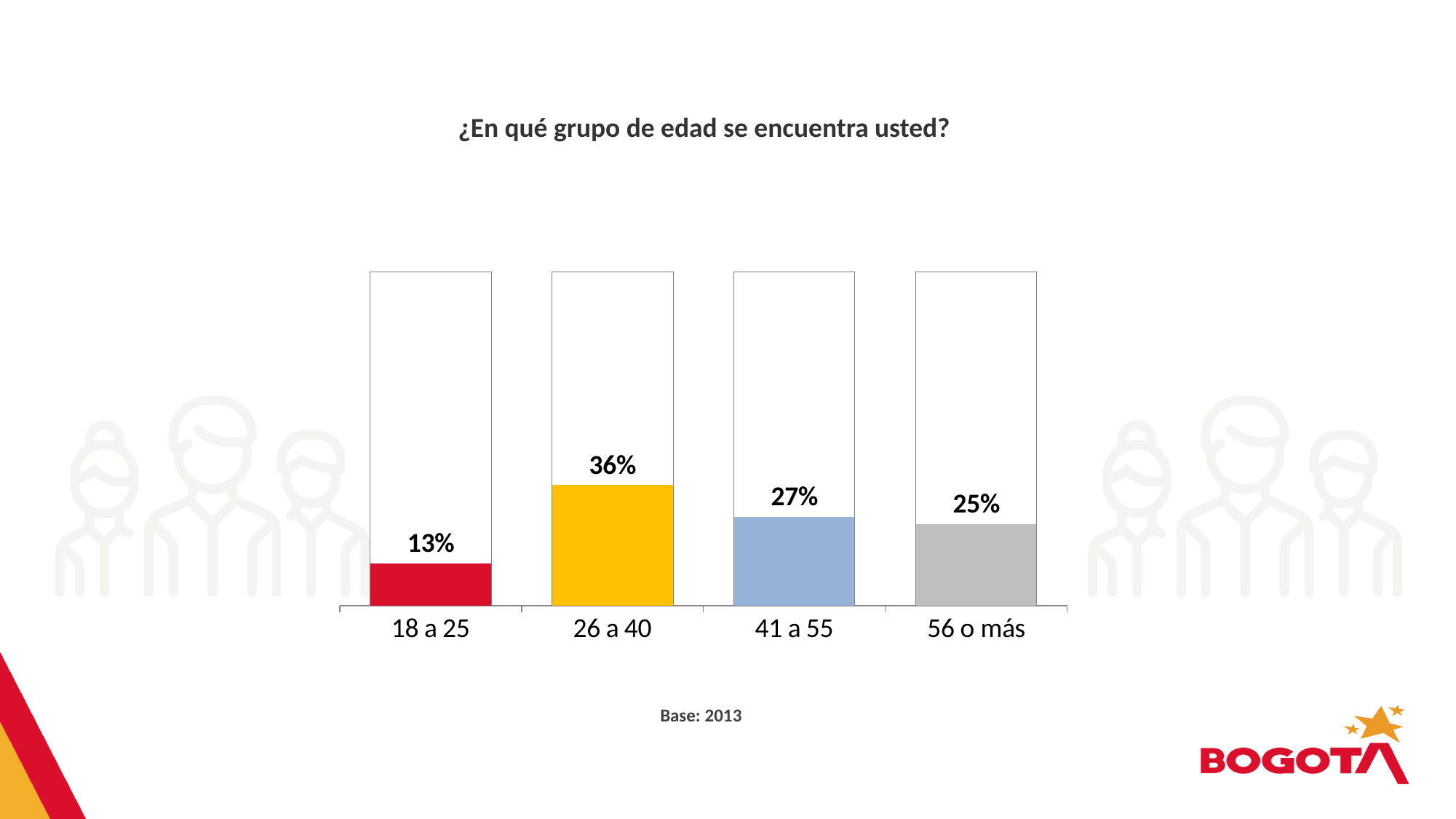
Which age group has the lowest percentage of respondents? 18 a 25 What percentage of respondents are in the 18 a 25 age group? 13% What is the difference in percentage points between the 26 a 40 group and the 18 a 25 group? 23 What kind of chart is shown on the slide? Bar chart How many age groups are shown in the chart? 4 Which age group has the highest percentage of respondents? 26 a 40 What percentage of respondents are in the 26 a 40 age group? 36% What percentage of respondents are in the 41 a 55 age group? 27% Which has a larger share of respondents, 41 a 55 or 56 o más? 41 a 55 What is the base (number of respondents) stated below the chart? 2013 What percentage of respondents are in the 56 o más age group? 25% What is the difference in percentage points between the 41 a 55 group and the 56 o más group? 2